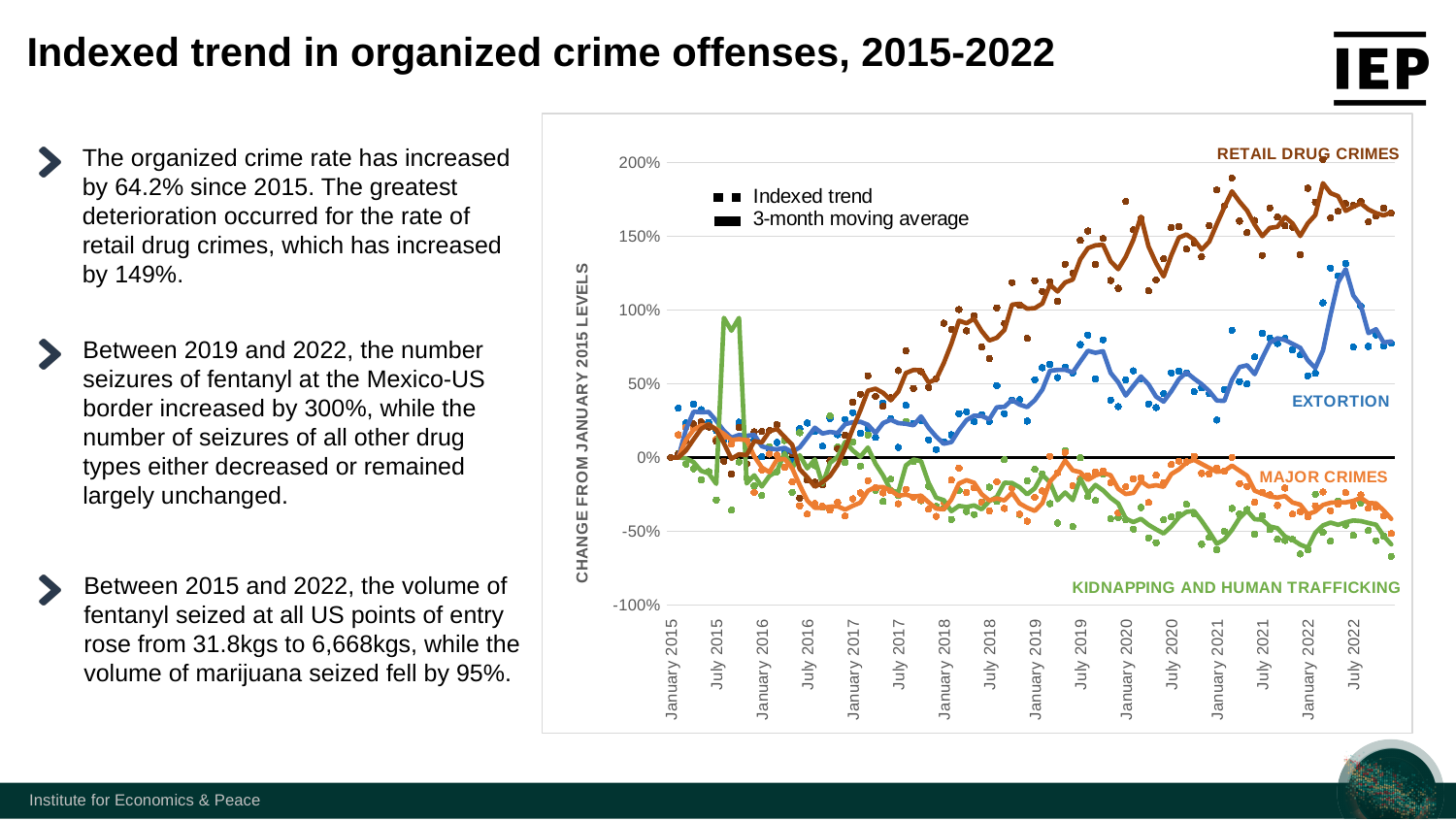
Does the kidnapping and human trafficking series rise or fall overall from January 2015 to July 2022? fall What two entries does the chart legend list? Indexed trend; 3-month moving average What is the label on the vertical axis of the chart? CHANGE FROM JANUARY 2015 LEVELS Is the 3-month moving average for kidnapping and human trafficking in July 2022 greater or less than 0%? less Which crime category has the lowest indexed value at the end of the period (July 2022)? Kidnapping and human trafficking What kind of chart is shown on the slide? line chart Is the 3-month moving average for retail drug crimes in July 2022 greater or less than 150%? greater Which crime category has the highest indexed value at the end of the period (July 2022)? Retail drug crimes Does the retail drug crimes series rise or fall overall from January 2015 to July 2022? rise How many crime categories are plotted on the chart? 4 Is the peak value reached by the extortion 3-month moving average greater or less than 100%? greater In July 2022, which is higher: extortion or major crimes? Extortion